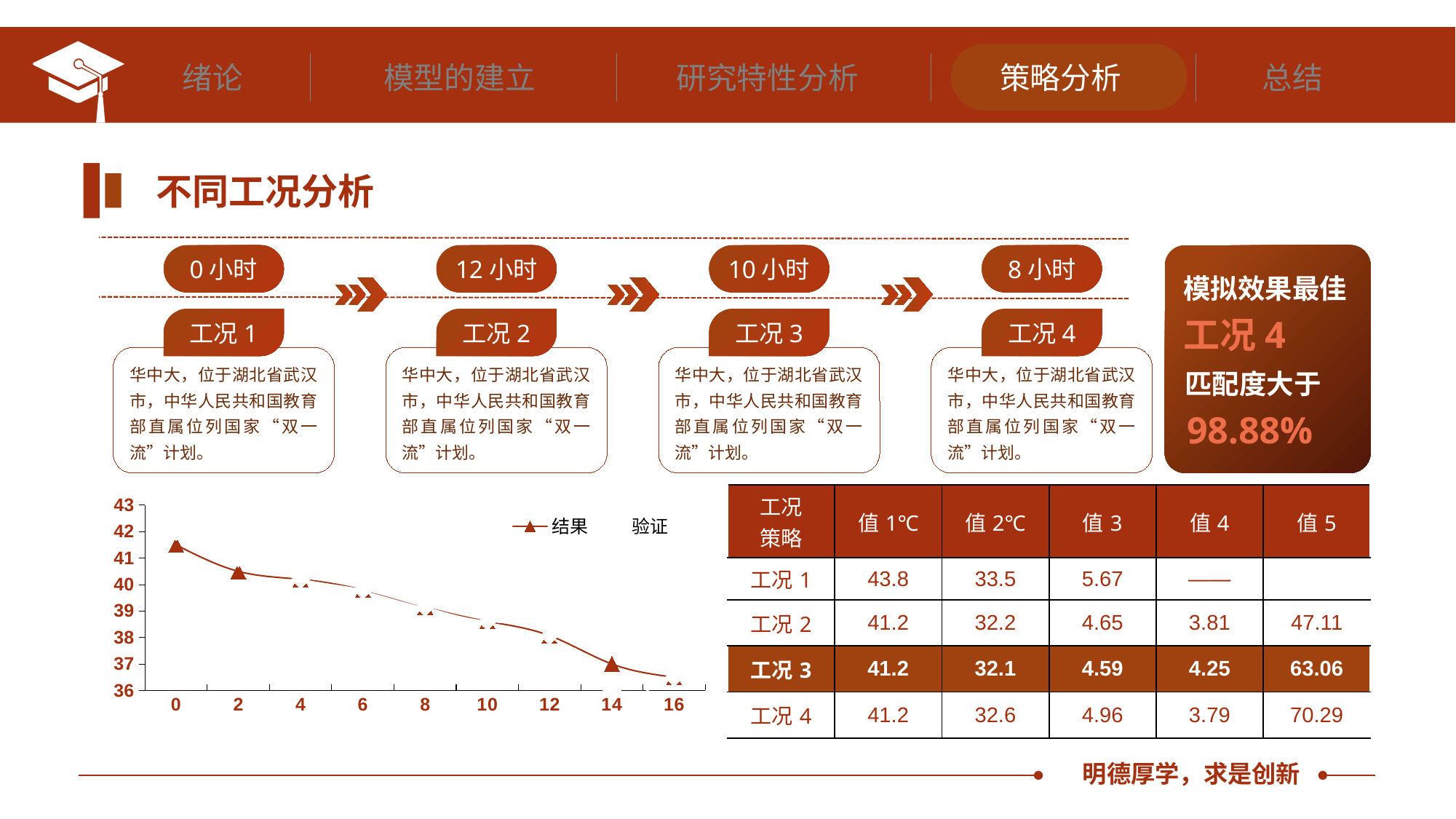
How many tick labels are shown on the x axis of the line chart? 9 In the line chart, is the value of 结果 at x = 0 greater or less than 41? greater In the line chart, is the value of 结果 at x = 2 greater or less than 40? greater In the line chart, which is larger: the 结果 value at x = 0 or at x = 14? x = 0 In the line chart, at which x value is the 结果 series highest? 0 In the line chart, do the values rise or fall as x increases from 0 to 16? fall How many series does the legend of the line chart list? 2 In the line chart, is the value at x = 16 greater or less than 37? less What is the range of the y axis in the line chart? 36 to 43 What kind of chart is shown at the bottom left of the slide? line chart What are the two series named in the legend of the line chart? 结果 and 验证